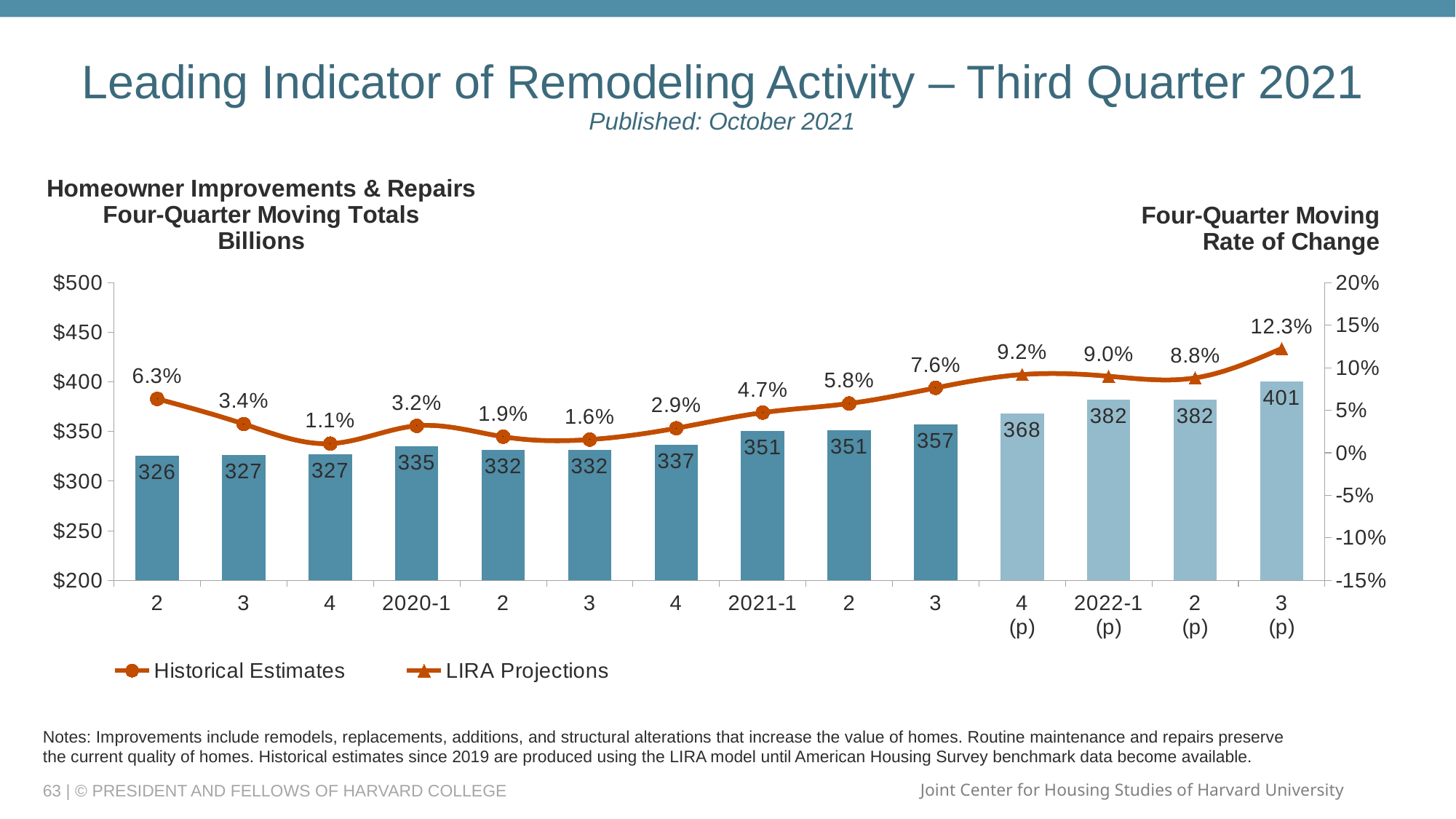
What is the four-quarter moving rate of change for 2020-1? 3.2% How many series does the legend list? 2 Which quarter has the highest four-quarter moving total bar? 3 (p) How many quarters are shown on the x axis? 14 By how many percentage points does the rate of change for 3 (p) exceed that for 2 (p)? 3.5 What is the difference between the four-quarter moving total for 3 (p) and the first bar on the left? 75 What kind of chart is shown on the slide? Combined bar and line chart What is the four-quarter moving total (billions) for 2021-1? 351 What is the lowest four-quarter moving rate of change shown on the line? 1.1% Which has the larger four-quarter moving total, 2020-1 or 2021-1? 2021-1 What is the four-quarter moving rate of change for 2022-1 (p)? 9.0% Is the four-quarter moving total bar for 2022-1 (p) greater or less than $350? greater